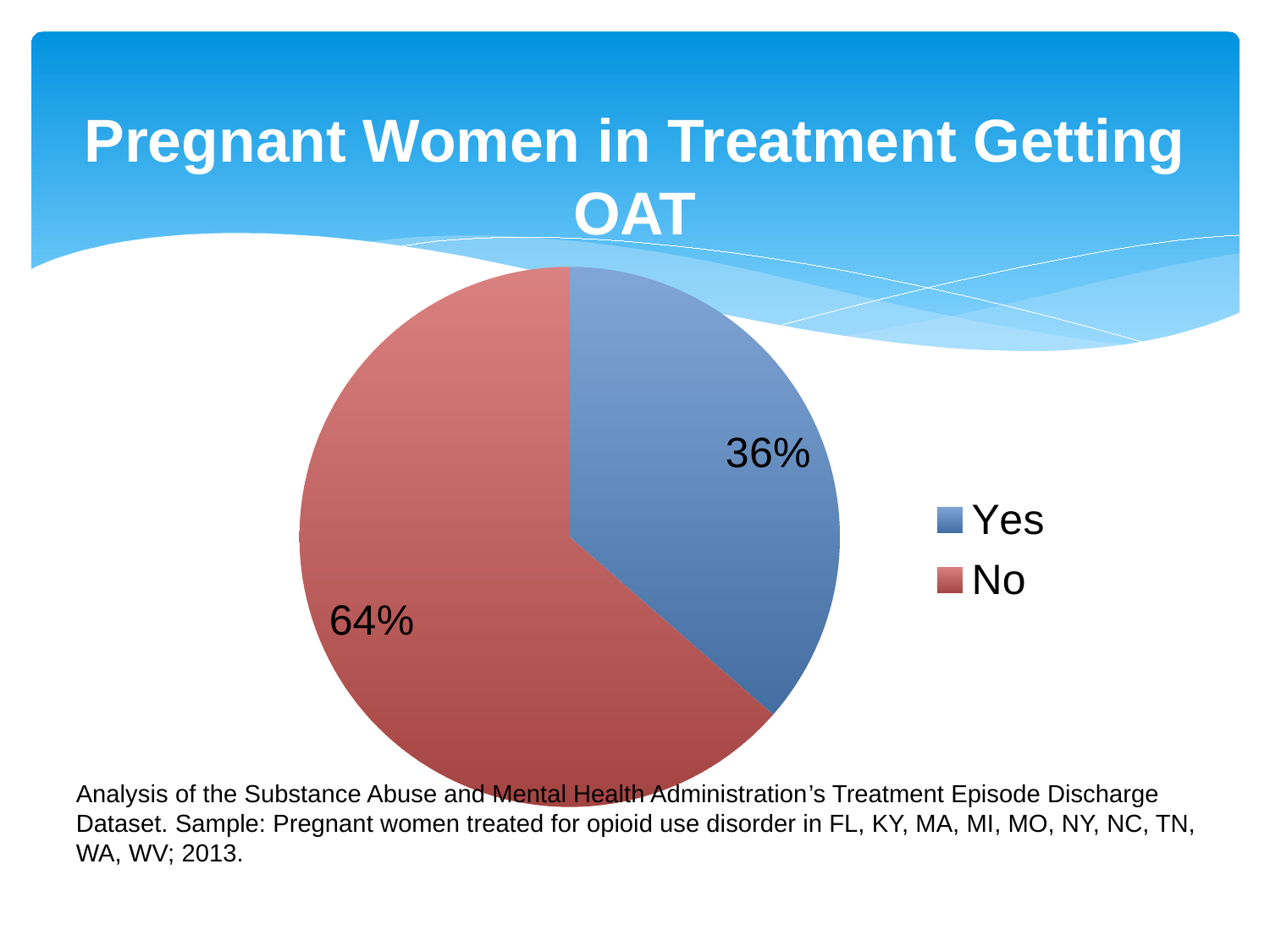
How many entries does the legend list? 2 What is the difference in percentage points between the "No" and "Yes" slices? 28 What kind of chart is shown on the slide? pie chart Which is larger, the "Yes" slice or the "No" slice? No Which slice is the largest? No What is the title of the slide containing the chart? Pregnant Women in Treatment Getting OAT What percentage is shown for the "No" slice? 64% What percentage of pregnant women in treatment are getting OAT (the "Yes" slice)? 36% Which slice is the smallest? Yes What share of the pie does the "Yes" slice represent? 36% How many slices does the pie chart have? 2 What colour is the "No" slice in the pie chart? red